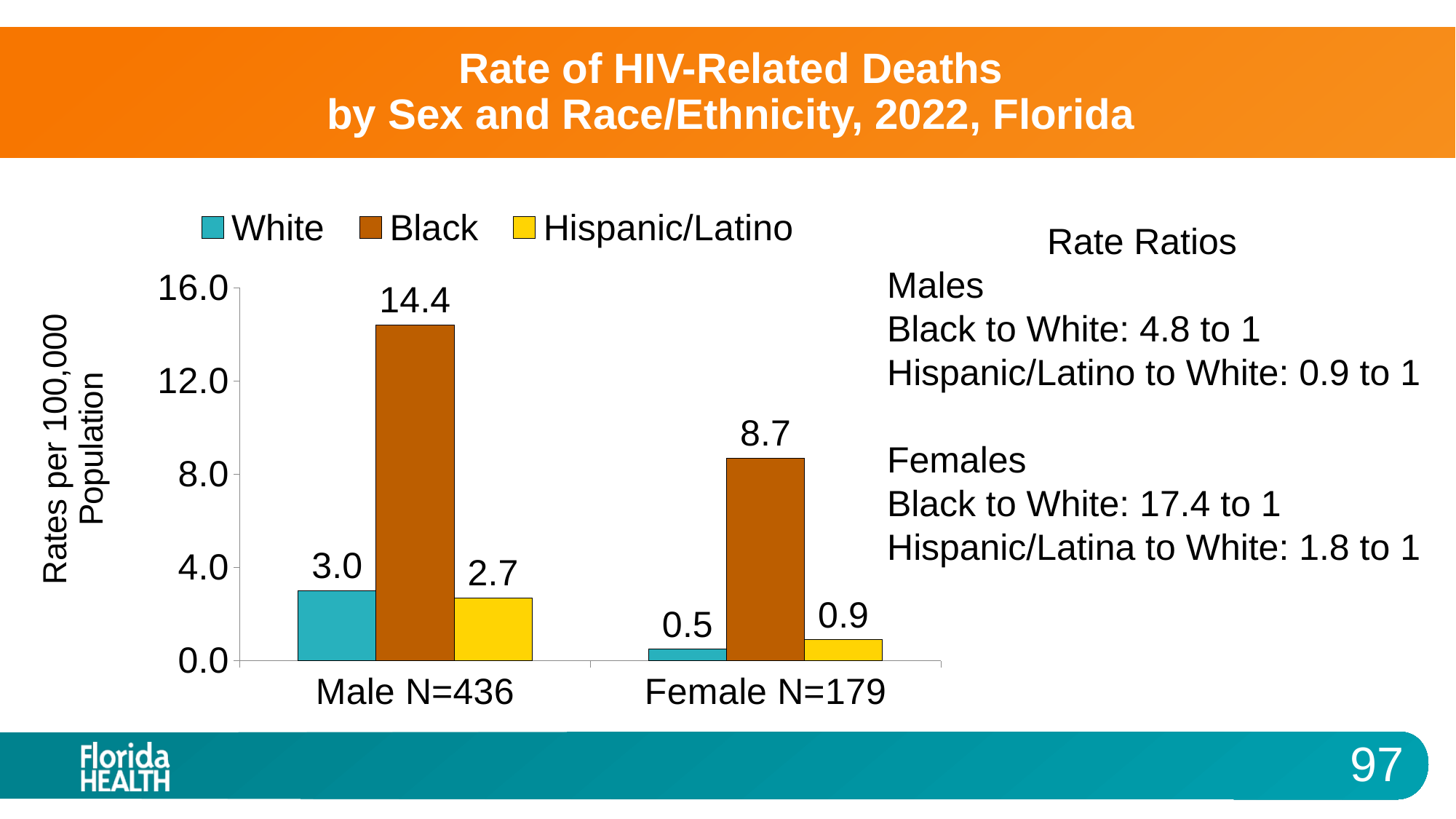
What is the rate of HIV-related deaths for Hispanic/Latino males? 2.7 What is the rate of HIV-related deaths for White females? 0.5 What is the N shown for the Female category on the x axis? N=179 Which is larger, the White male rate or the Hispanic/Latino male rate? White male rate Which race/ethnicity group has the highest death rate among females? Black Is the value for Black females greater or less than 8.0? greater What is the difference between the Black male rate and the Black female rate? 5.7 What is the label of the y axis? Rates per 100,000 Population What kind of chart is shown on the slide? Bar chart How many series does the legend list? 3 Which race/ethnicity group has the lowest death rate among females? White What is the rate of HIV-related deaths for Black males? 14.4